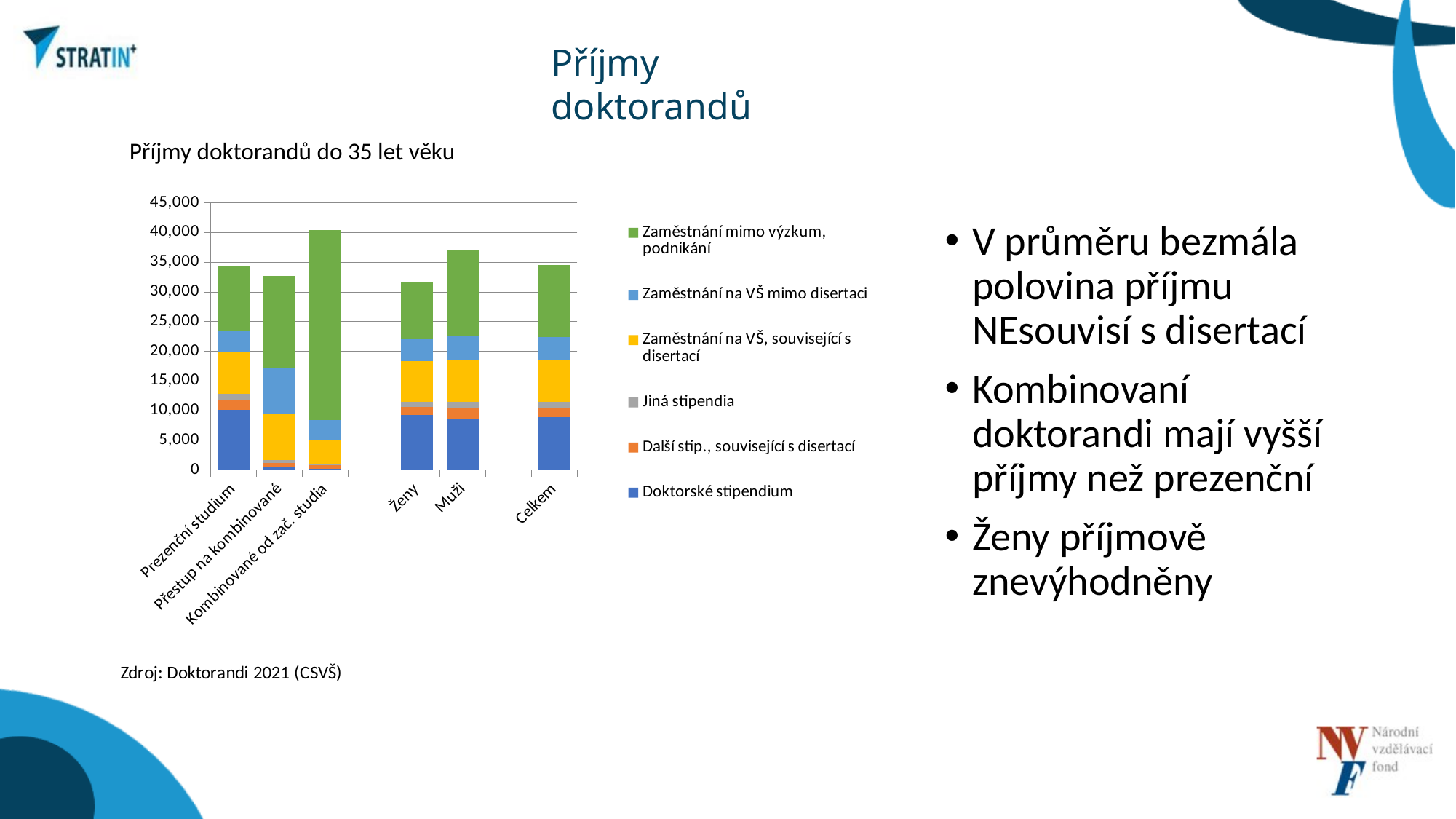
Is the Doktorské stipendium value for Kombinované od zač. studia greater or less than 5,000? less How many series does the chart legend list? 6 How many categories are shown on the x axis of the chart? 6 What kind of chart is shown on the slide? Stacked bar chart What is the title of the chart? Příjmy doktorandů do 35 let věku Is the total bar for Ženy greater or less than 35,000? less Which has the higher total bar, Muži or Ženy? Muži Which has the higher total bar, Kombinované od zač. studia or Prezenční studium? Kombinované od zač. studia Is the total bar for Kombinované od zač. studia greater or less than 35,000? greater Which series is shown at the bottom of each stacked bar? Doktorské stipendium Which category has the highest total bar? Kombinované od zač. studia